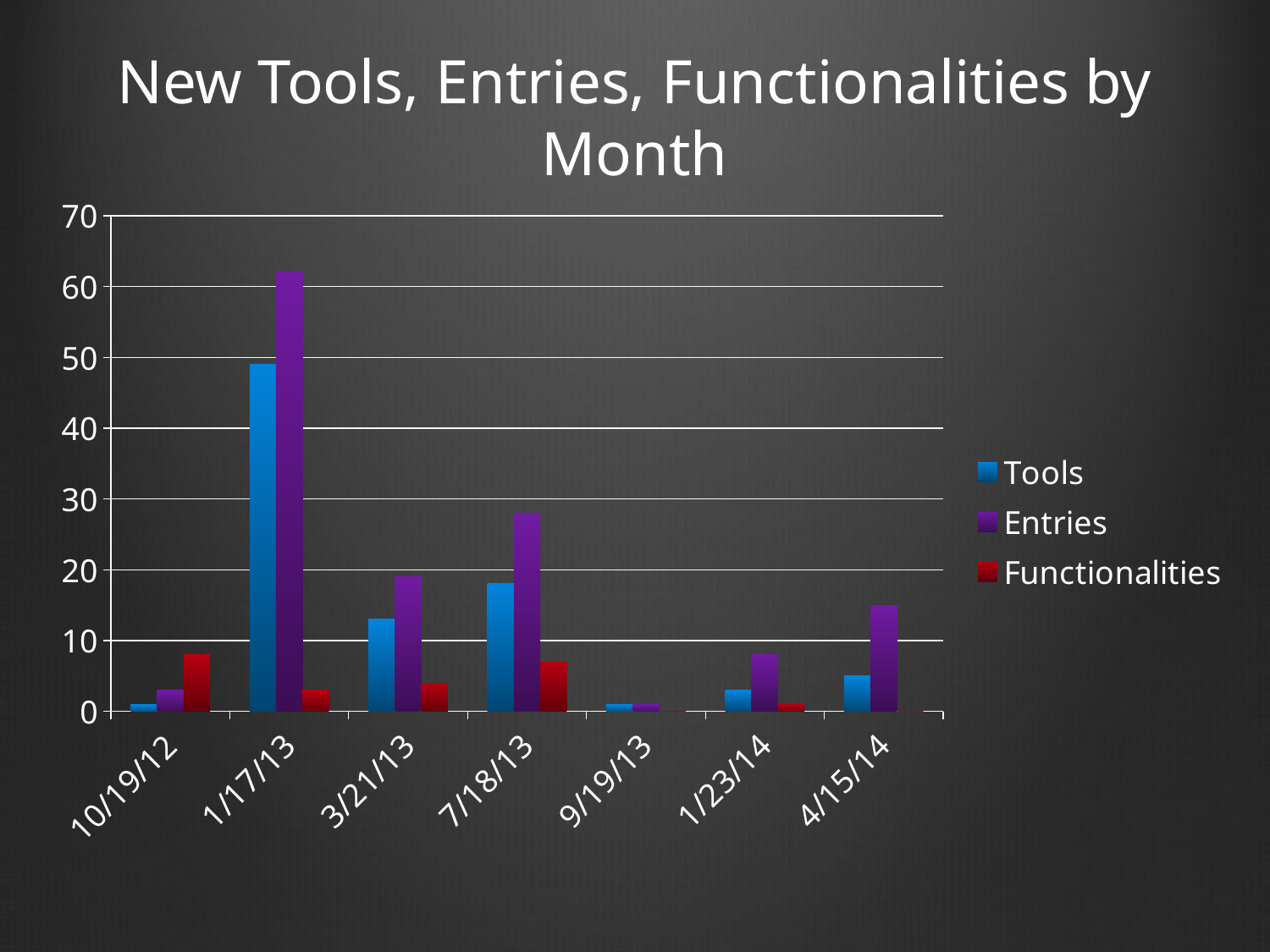
Which series is shown in purple? Entries Is the Tools value for 1/17/13 greater or less than 40? greater Which is larger for 7/18/13, Tools or Entries? Entries What is the title of the chart? New Tools, Entries, Functionalities by Month On which date is the Tools value highest? 1/17/13 How many dates are shown along the x axis? 7 Is the Entries value for 7/18/13 greater or less than 20? greater Which date has the larger Functionalities value, 10/19/12 or 1/17/13? 10/19/12 What type of chart is shown on the slide? bar chart On which date is the Entries value highest? 1/17/13 How many series does the legend list? 3 Is the Functionalities value for 10/19/12 greater or less than 10? less